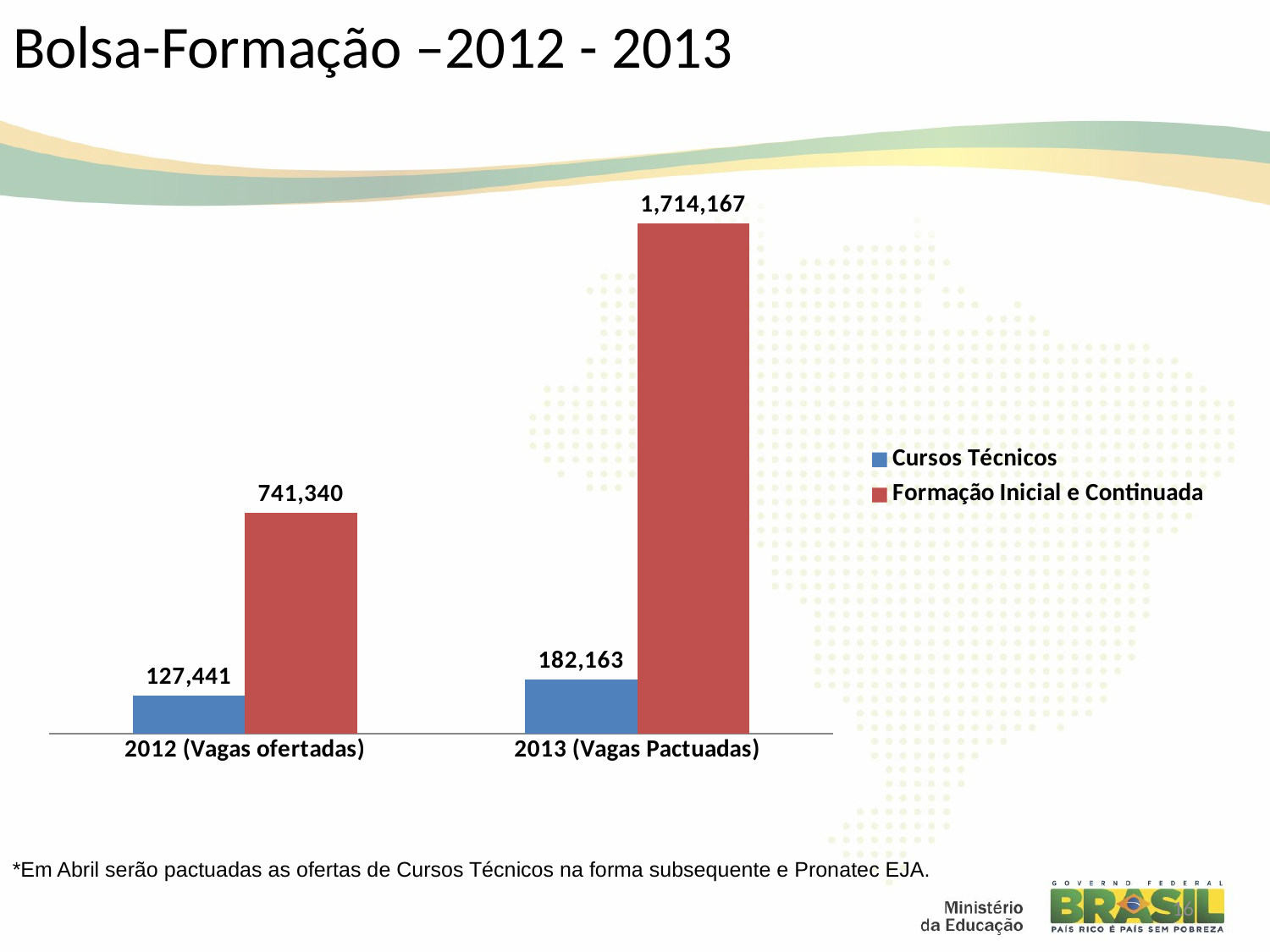
What kind of chart is shown on the slide? Bar chart By how much did the Cursos Técnicos value increase from 2012 (Vagas ofertadas) to 2013 (Vagas Pactuadas)? 54,722 How many categories are shown on the x axis? 2 Which bar has the lowest value on the chart? Cursos Técnicos in 2012 (Vagas ofertadas) What is the value for Cursos Técnicos in 2012 (Vagas ofertadas)? 127,441 Which is larger: Formação Inicial e Continuada in 2012 (Vagas ofertadas) or Cursos Técnicos in 2013 (Vagas Pactuadas)? Formação Inicial e Continuada in 2012 (Vagas ofertadas) Which bar has the highest value on the chart? Formação Inicial e Continuada in 2013 (Vagas Pactuadas) What is the value for Formação Inicial e Continuada in 2012 (Vagas ofertadas)? 741,340 What is the difference between Formação Inicial e Continuada and Cursos Técnicos in 2013 (Vagas Pactuadas)? 1,532,004 How many series does the legend list? 2 What is the value for Cursos Técnicos in 2013 (Vagas Pactuadas)? 182,163 What is the value for Formação Inicial e Continuada in 2013 (Vagas Pactuadas)? 1,714,167